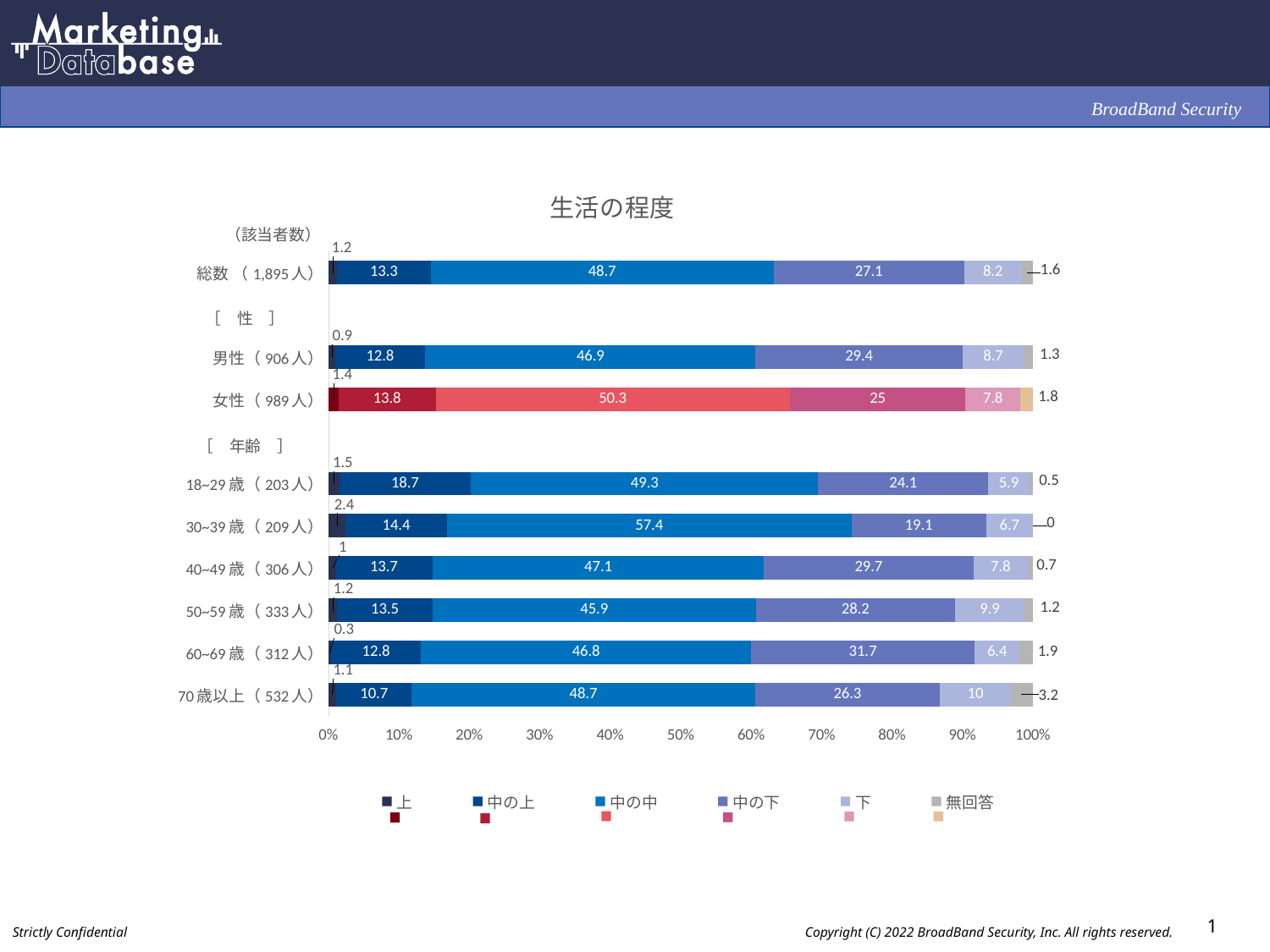
Which category has the lowest value for 上? 60~69歳 (312人) What is the difference between the 中の中 values for 女性 (989人) and 男性 (906人)? 3.4 What is the value of 中の中 for 総数 (1,895人)? 48.7 What kind of chart is shown on the slide? Stacked bar chart How many series does the legend list? 6 What is the value of 中の下 for 60~69歳 (312人)? 31.7 Which is larger, the 中の上 value for 18~29歳 (203人) or for 70歳以上 (532人)? 18~29歳 (203人) Which category has the highest value for 中の中? 30~39歳 (209人) What is the value of 上 for 30~39歳 (209人)? 2.4 How many categories (bars) are plotted in the chart? 9 What is the value of 下 for 70歳以上 (532人)? 10 What is the title of the chart? 生活の程度